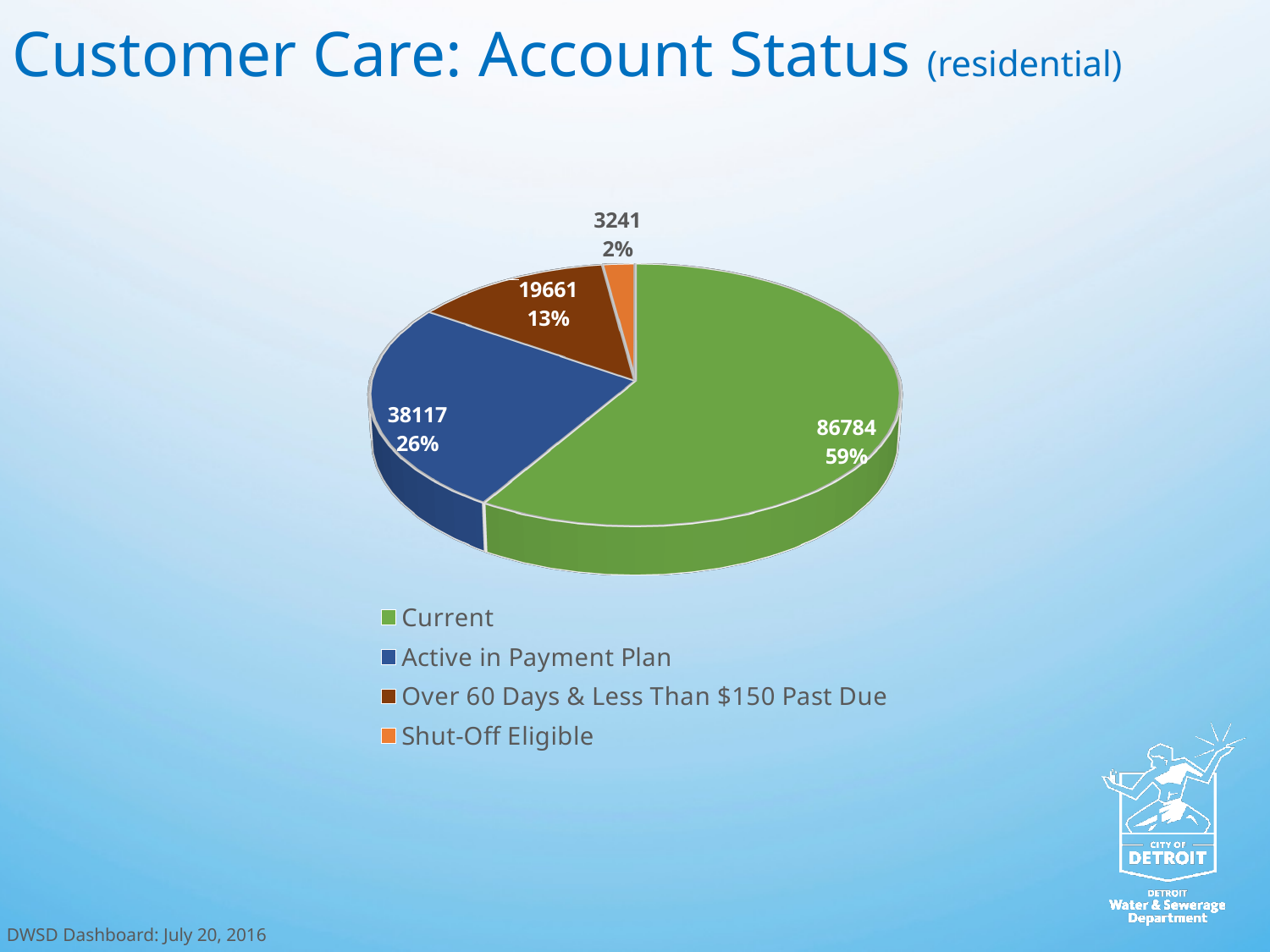
What is the value for Shut-Off Eligible? 3241 Which colour represents Over 60 Days & Less Than $150 Past Due in the legend? brown What is the value for Current? 86784 What is the difference between the values for Current and Active in Payment Plan? 48667 What is the value for Active in Payment Plan? 38117 What share of the pie does Current represent? 59% Which category has the smallest slice? Shut-Off Eligible How many categories does the pie chart show? 4 What share of the pie does Active in Payment Plan represent? 26% What kind of chart is shown on the slide? pie chart What is the value for Over 60 Days & Less Than $150 Past Due? 19661 Which category has the largest slice? Current